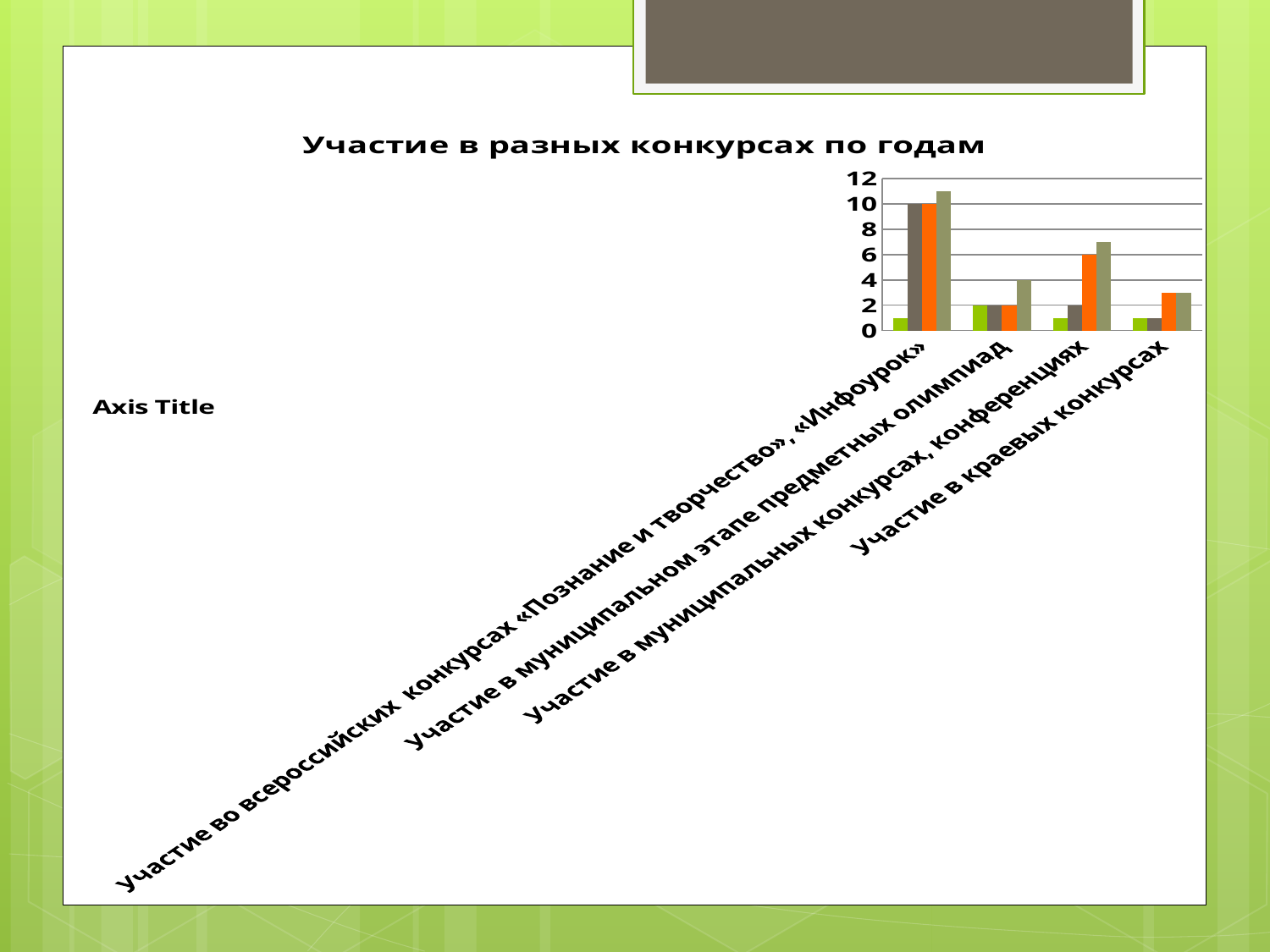
What is the value of the orange bar for «Участие во всероссийских конкурсах «Познание и творчество», «Инфоурок»»? 10 What is the highest value shown on the vertical axis of the chart? 12 Is the value of the green bar for «Участие в краевых конкурсах» greater or less than 2? less Is the value of the light gray bar for «Участие во всероссийских конкурсах «Познание и творчество», «Инфоурок»» greater or less than 10? greater What is the value of the light gray bar for «Участие в муниципальном этапе предметных олимпиад»? 4 How many bars are plotted for each category in the chart? 4 What is the title of the chart? Участие в разных конкурсах по годам Which is larger: the orange bar for «Участие в муниципальных конкурсах, конференциях» or the orange bar for «Участие в краевых конкурсах»? Участие в муниципальных конкурсах, конференциях Which category has the tallest bar in the chart? Участие во всероссийских конкурсах «Познание и творчество», «Инфоурок» What type of chart is shown on the slide? bar chart What is the value of the orange bar for «Участие в муниципальных конкурсах, конференциях»? 6 How many categories are shown on the x axis of the chart? 4